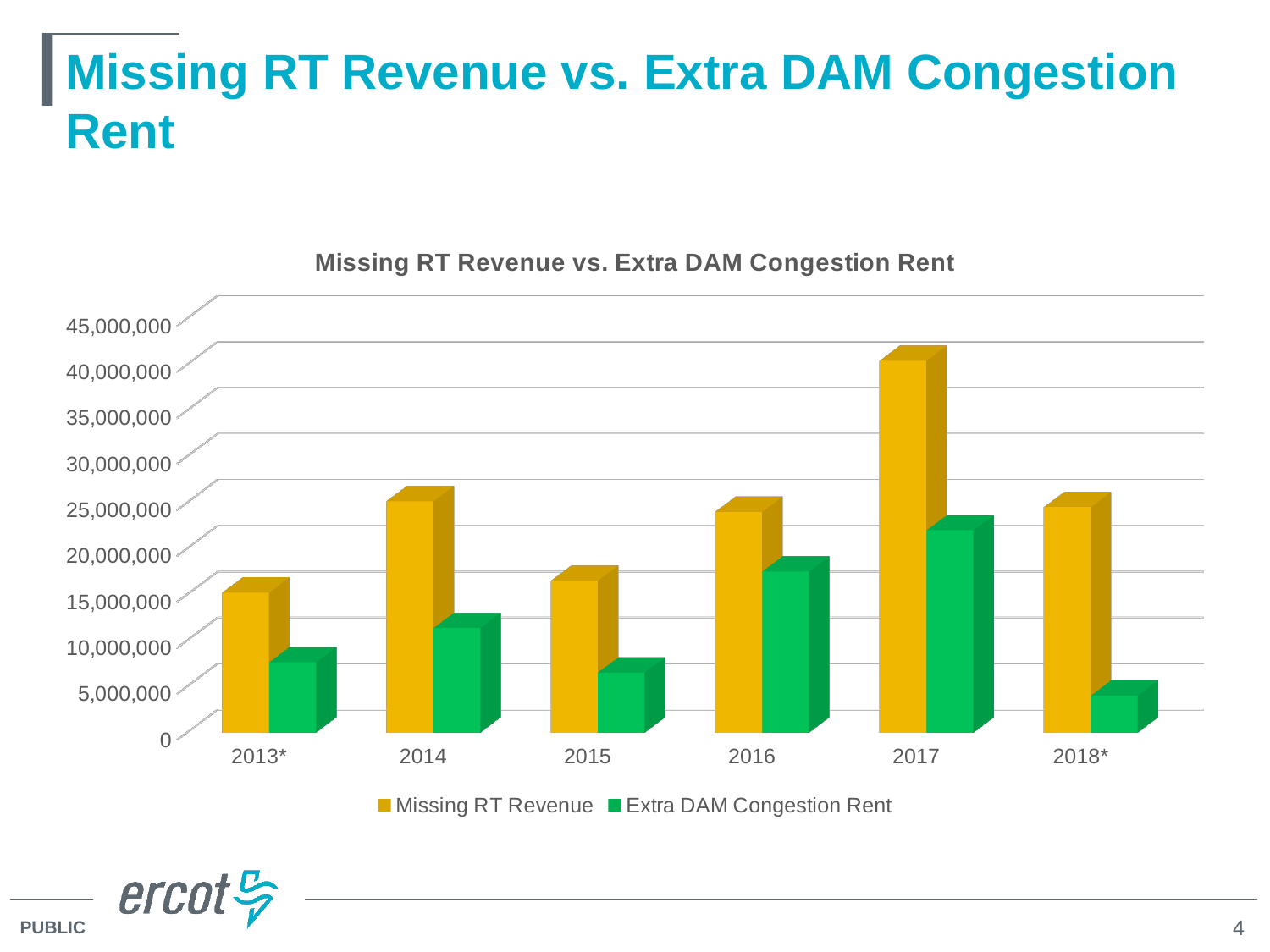
Which year has the lowest Extra DAM Congestion Rent? 2018* Is the Extra DAM Congestion Rent for 2013* greater or less than 10,000,000? less Is the Missing RT Revenue for 2017 greater or less than 35,000,000? greater Is the Missing RT Revenue for 2014 greater or less than 20,000,000? greater How many series does the chart's legend list? 2 Which colour represents Extra DAM Congestion Rent in the chart? Green Which year has the highest Extra DAM Congestion Rent? 2017 In 2017, which is larger: Missing RT Revenue or Extra DAM Congestion Rent? Missing RT Revenue Between 2015 and 2017, does Extra DAM Congestion Rent rise or fall? Rise What kind of chart is shown on the slide? Bar chart How many years are shown on the x axis of the chart? 6 Which year has the highest Missing RT Revenue? 2017